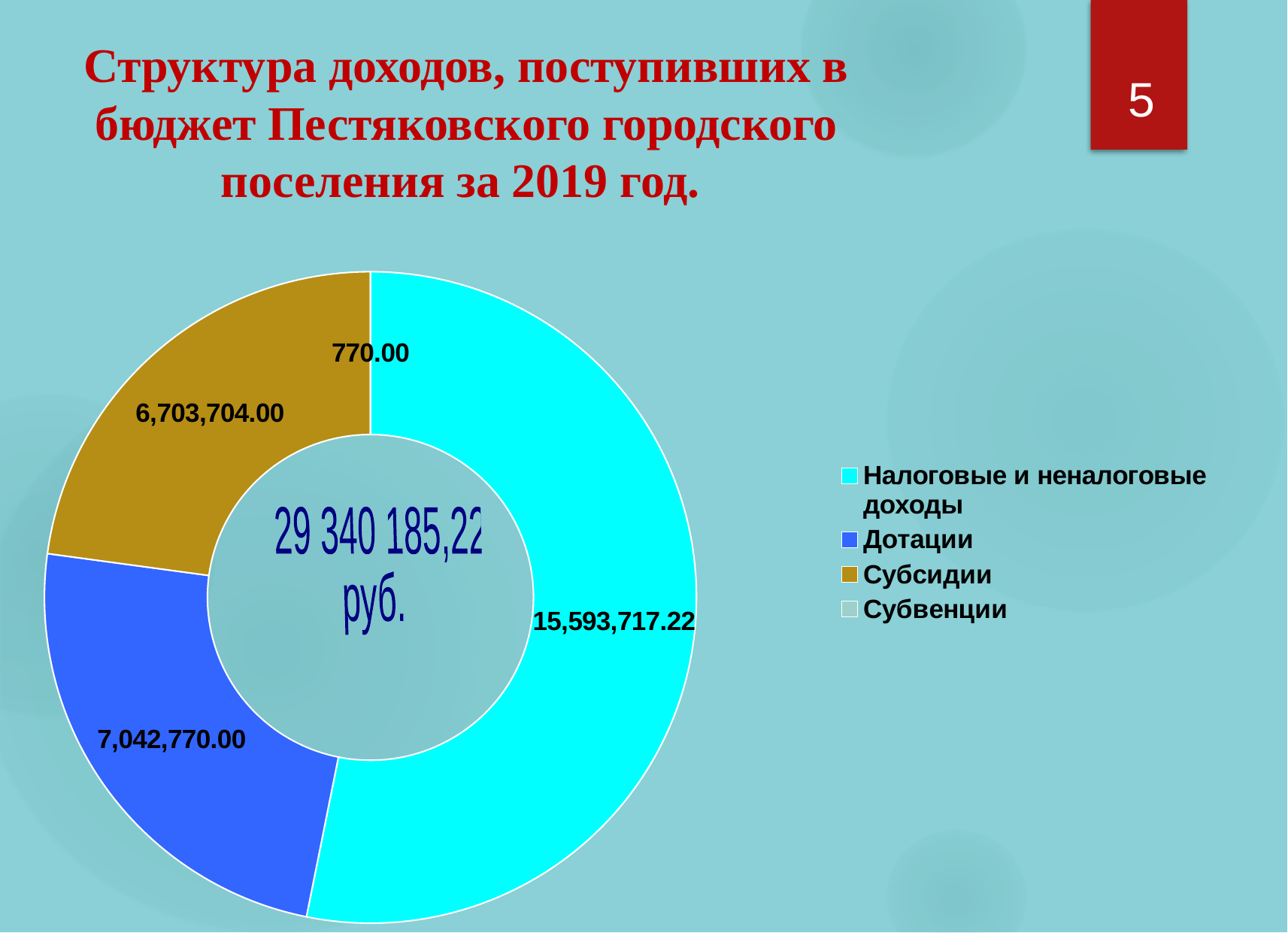
What total amount is written in the centre of the doughnut chart? 29 340 185,22 руб. What is the value shown for Дотации? 7,042,770.00 What type of chart is shown on the slide? Doughnut (pie) chart Which is larger, Дотации or Субсидии? Дотации How many categories does the legend list? 4 What is the difference between the values for Дотации and Субсидии? 339,066.00 What is the value shown for Субсидии? 6,703,704.00 What is the difference between the values for Налоговые и неналоговые доходы and Дотации? 8,550,947.22 What is the value shown for Налоговые и неналоговые доходы? 15,593,717.22 Which category has the largest value in the chart? Налоговые и неналоговые доходы What is the value shown for Субвенции? 770.00 Which category has the smallest value in the chart? Субвенции